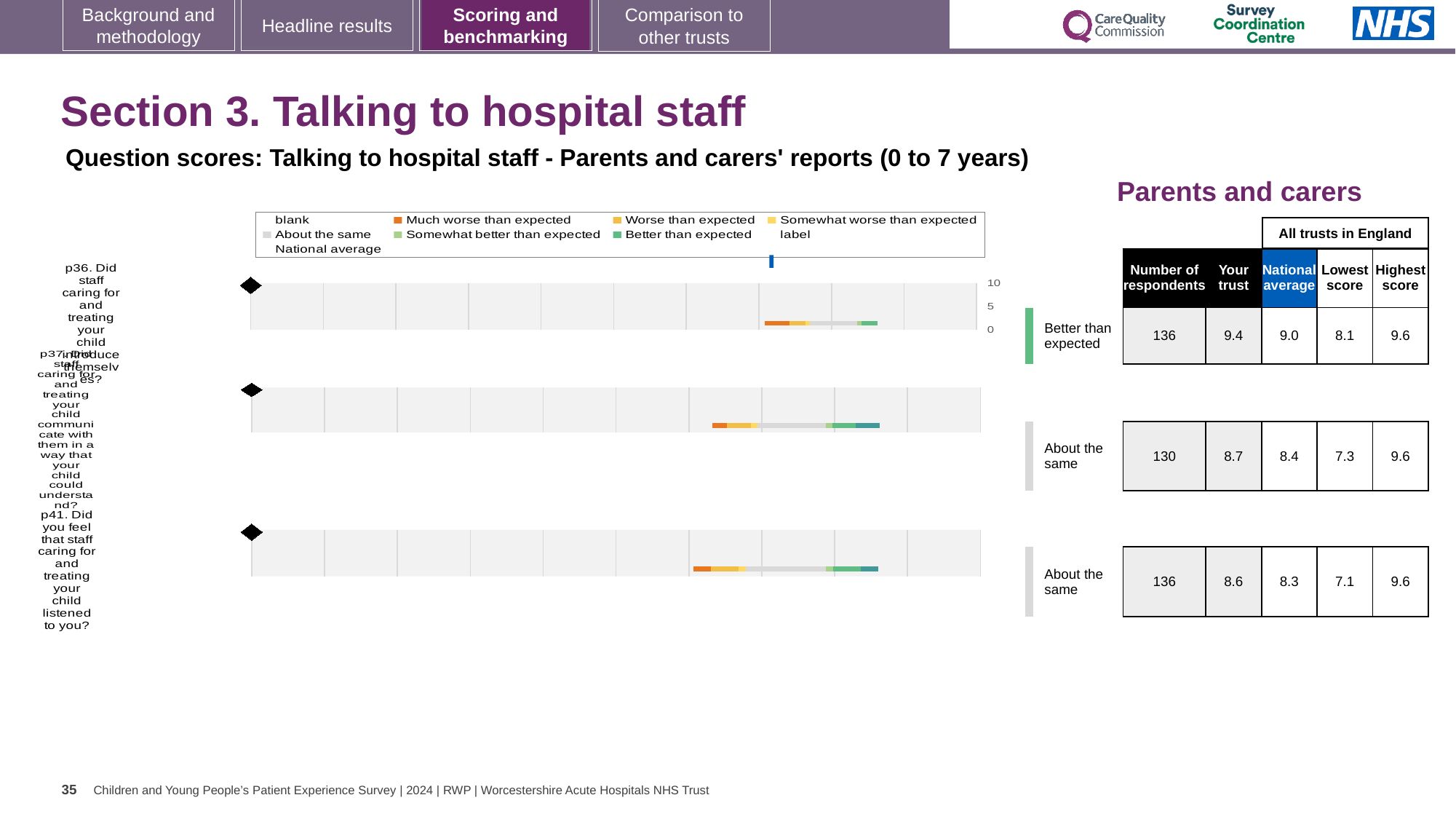
In the table beside the chart, how many respondents are listed for the bottom row? 136 In the table beside the chart, for the middle row, which is larger: 'Your trust' or 'National average'? Your trust In the table beside the chart, what is the 'Lowest score' for the bottom row? 7.1 In the table beside the chart, what is the 'National average' for the middle row? 8.4 What is the highest value shown on the chart's numeric axis? 10 In the table beside the chart, what is the 'Highest score' for the top row? 9.6 What kind of chart is shown on the slide? bar chart How many survey questions (bars) are plotted in the chart? 3 What colour does the legend use for 'Better than expected'? green In the table beside the chart, what is the 'Your trust' score for the top row (Better than expected)? 9.4 In the table beside the chart, which row has the highest 'Your trust' score? the top row (Better than expected), 9.4 In the table beside the chart, what is the difference between 'Your trust' and 'National average' for the top row? 0.4